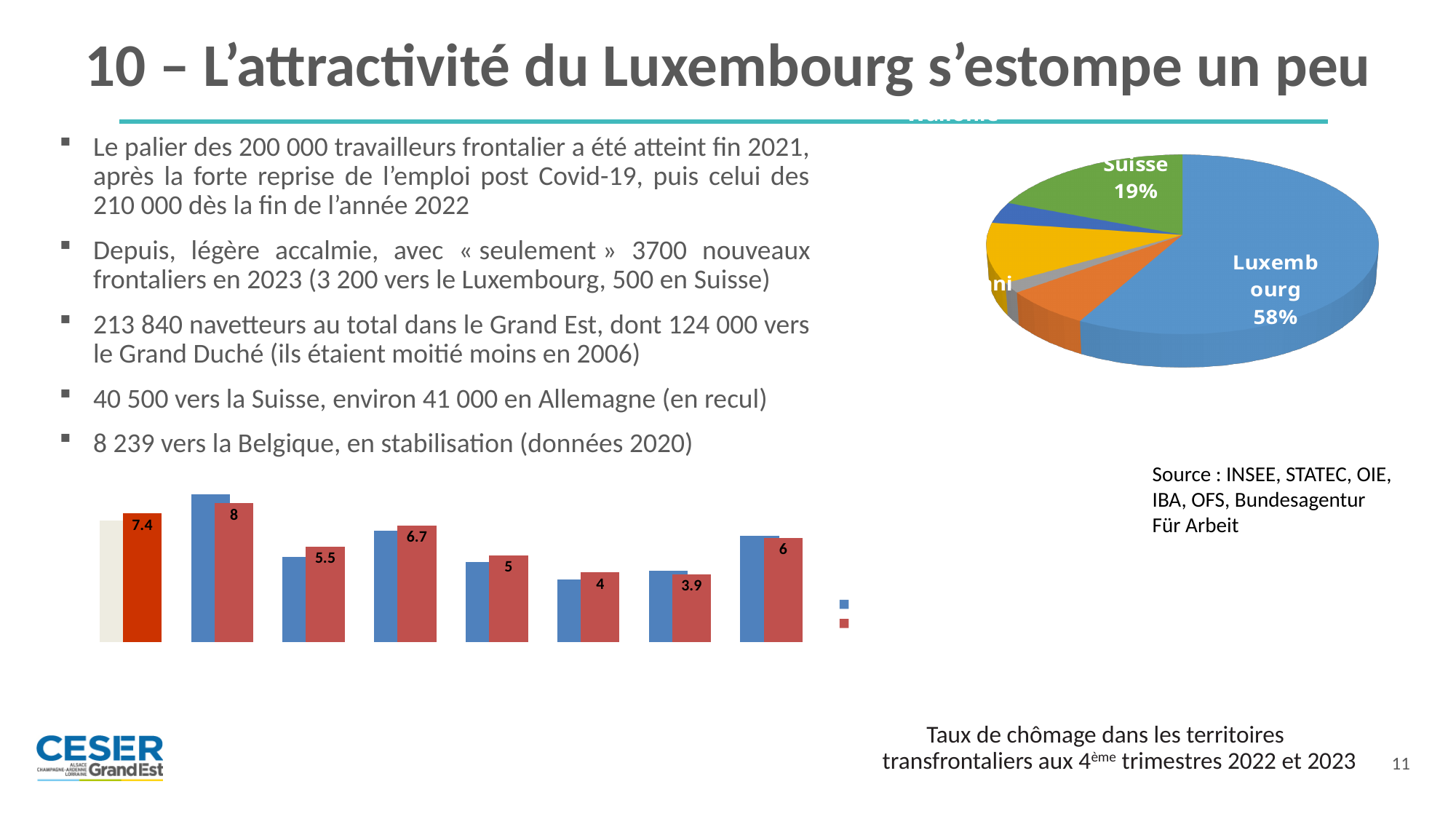
In the bar chart at the bottom left, how many series are plotted? 2 In the bar chart at the bottom left, what is the lowest value printed as a data label? 3.9 In the pie chart, what share does Suisse have? 19% In the pie chart, what is the difference in percentage points between the Luxembourg share and the Suisse share? 39 In the pie chart, what share does Luxembourg have? 58% In the bar chart at the bottom left, what is the highest value printed as a data label? 8 In the pie chart, which is larger, the Luxembourg slice or the Suisse slice? Luxembourg What kind of chart is the chart in the top right of the slide? pie chart In the pie chart, which labelled slice is the largest? Luxembourg What kind of chart is the chart in the bottom left of the slide? bar chart In the bar chart at the bottom left, what is the difference between the highest labelled value (8) and the lowest labelled value (3.9)? 4.1 In the bar chart at the bottom left, how many groups of bars are plotted? 8